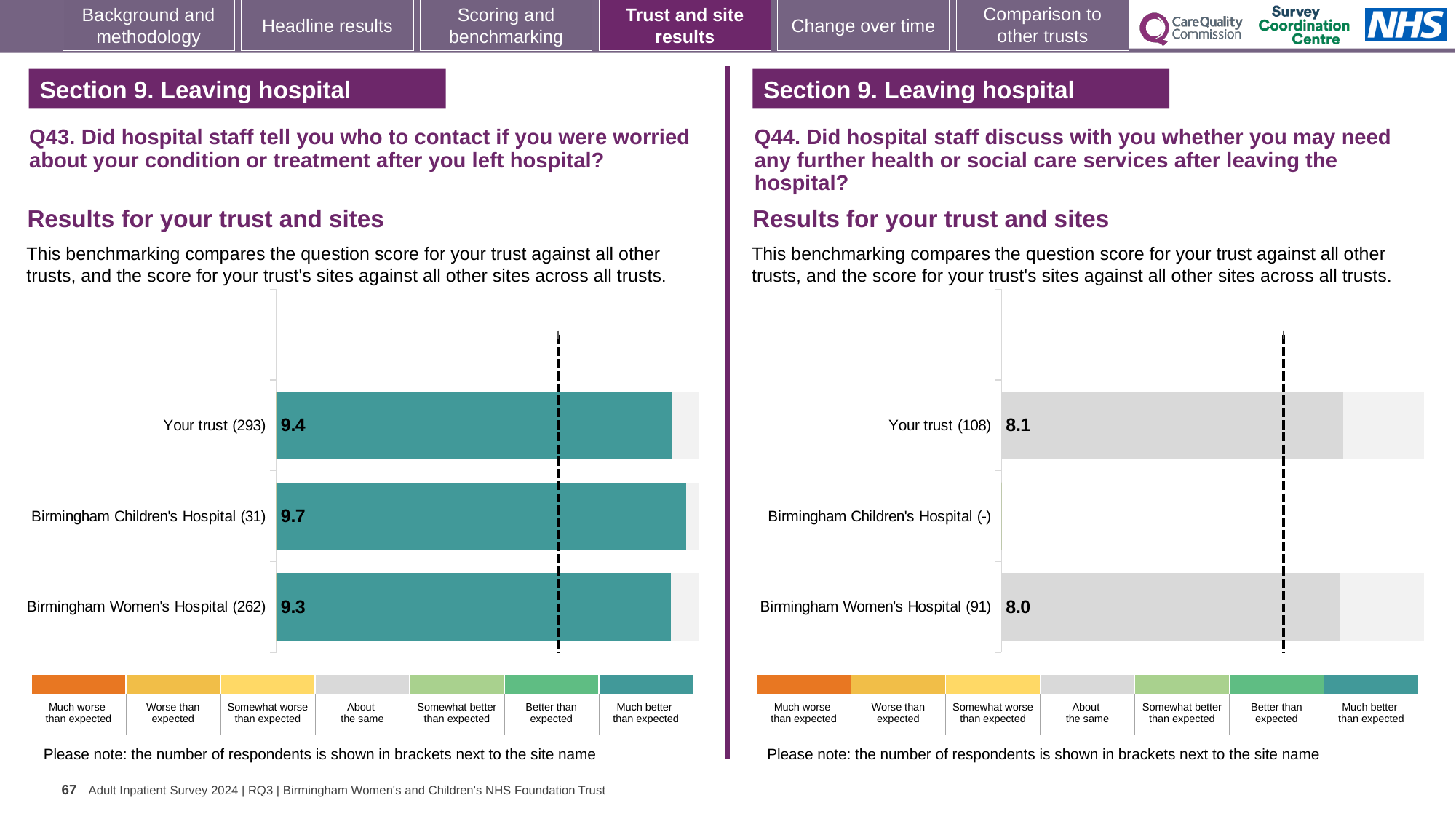
In the Q43 chart on the left, what is the score for Birmingham Women's Hospital? 9.3 In the Q43 chart on the left, how many respondents are shown for Birmingham Women's Hospital? 262 In the Q43 chart on the left, which site or trust has the lowest score? Birmingham Women's Hospital In the Q43 chart on the left, which site or trust has the highest score? Birmingham Children's Hospital In the Q44 chart on the right, what is the score for Birmingham Women's Hospital? 8.0 In the Q44 chart on the right, how many respondents are shown for Your trust? 108 In the Q44 chart on the right, what is the score for Your trust? 8.1 In the Q43 chart on the left, what is the difference between the scores for Birmingham Children's Hospital and Birmingham Women's Hospital? 0.4 What kind of chart is used in the Q43 chart on the left? Bar chart In the Q43 chart on the left, what is the score for Birmingham Children's Hospital? 9.7 In the Q43 chart on the left, what is the score for Your trust? 9.4 In the Q44 chart on the right, what is the difference between the scores for Your trust and Birmingham Women's Hospital? 0.1